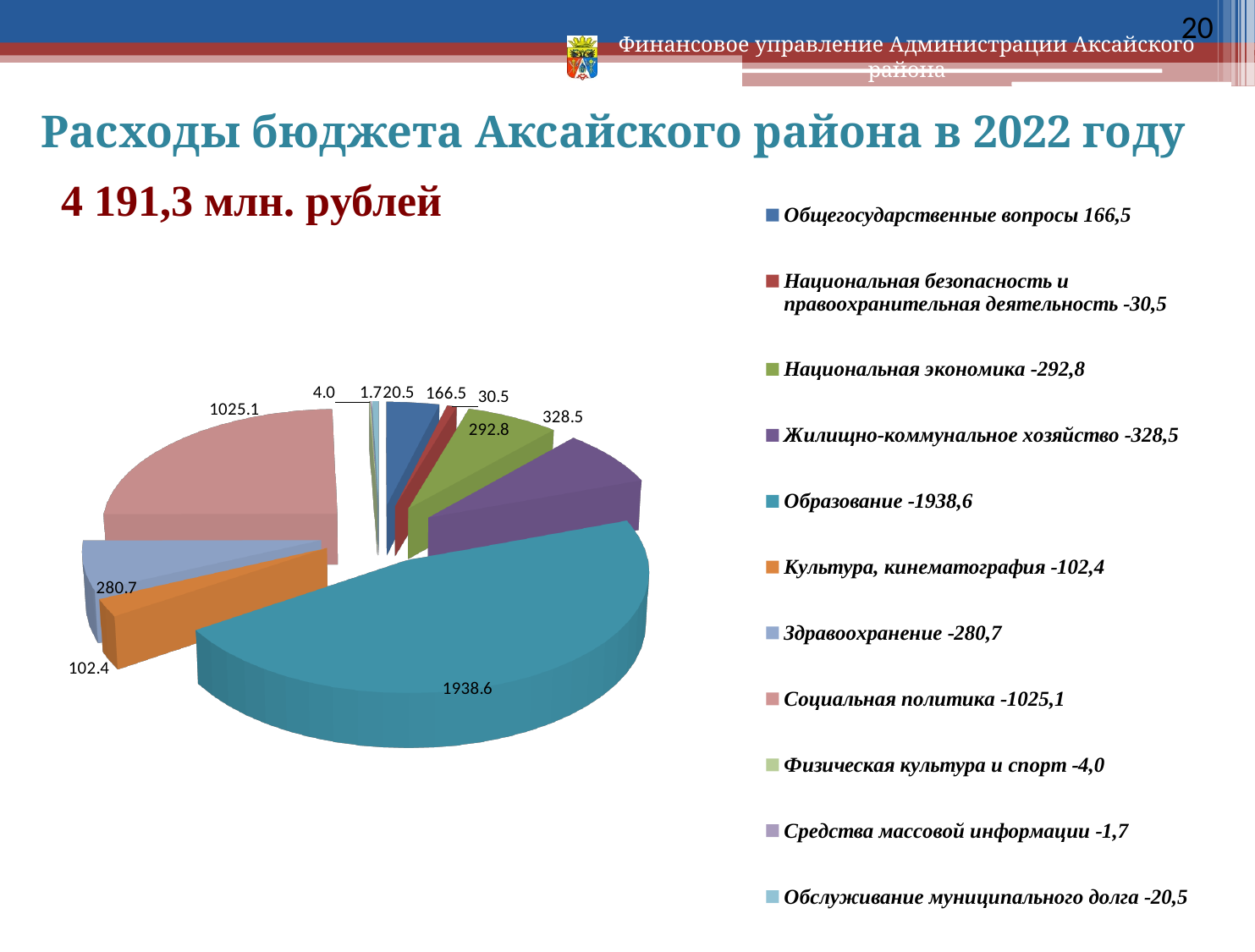
What is the value for Социальная политика? 1025.1 What is the difference between the values for Жилищно-коммунальное хозяйство and Национальная экономика? 35.7 What kind of chart is shown on the slide? pie chart What is the difference between the values for Образование and Социальная политика? 913.5 What total amount in million rubles is stated on the slide for the 2022 budget expenditures? 4 191,3 млн. рублей Which category has the largest slice of the pie? Образование How many categories does the legend list? 11 What is the value for Здравоохранение? 280.7 What is the value for Жилищно-коммунальное хозяйство? 328.5 Which is larger, the value for Здравоохранение or the value for Культура, кинематография? Здравоохранение What is the value for Образование? 1938.6 Which category has the smallest value? Средства массовой информации